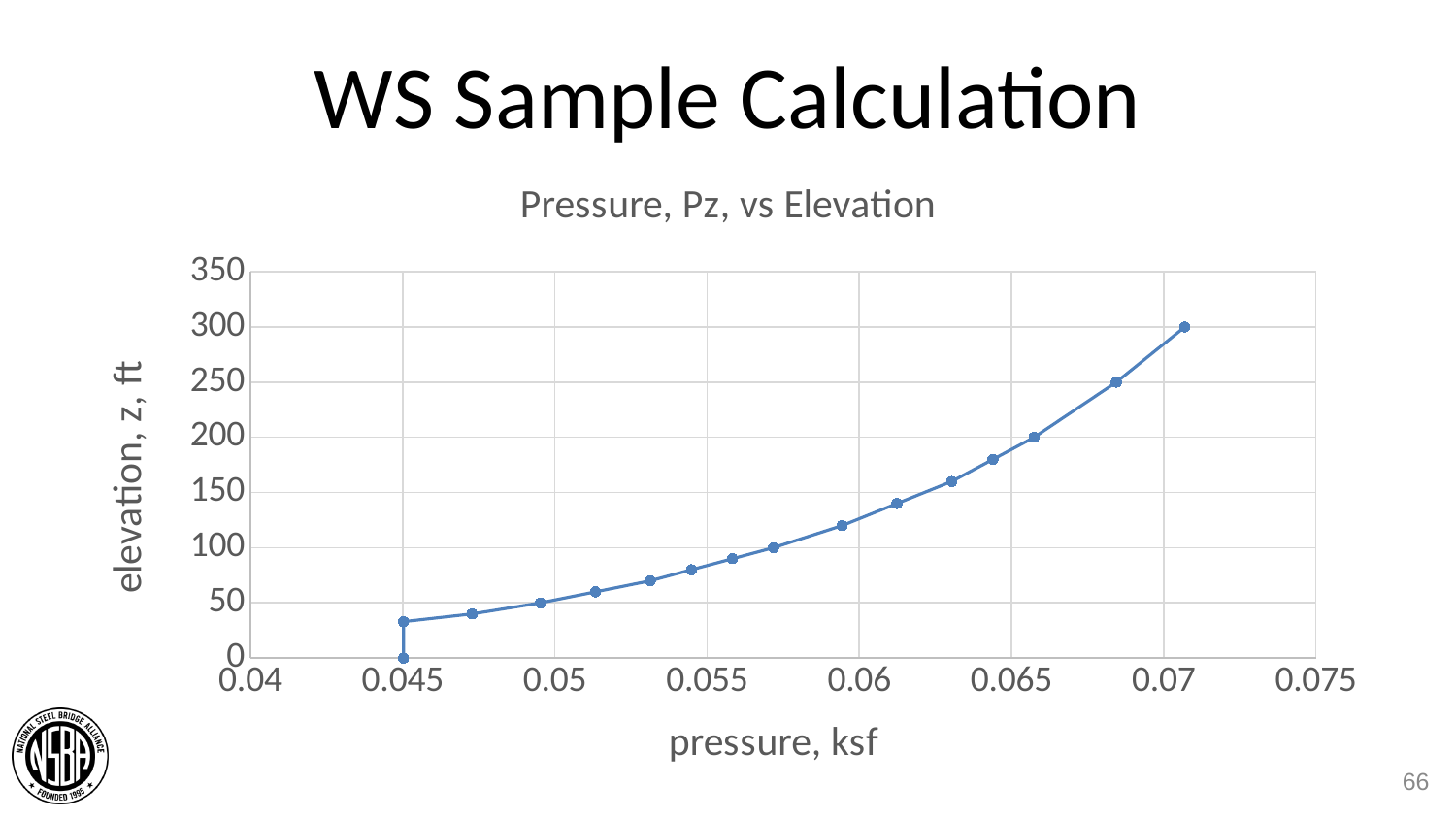
Is the pressure at an elevation of 300 ft greater or less than 0.07? greater What kind of chart is shown on the slide? line chart Is the pressure at an elevation of 50 ft greater or less than 0.05? less What is the highest elevation value plotted on the chart? 300 As pressure increases along the x axis, does elevation rise or fall? rise Is the pressure at an elevation of 200 ft greater or less than 0.065? greater What is the label of the horizontal axis of the chart? pressure, ksf How many data points are plotted on the chart? 16 What is the title of the chart? Pressure, Pz, vs Elevation What is the lowest pressure value plotted on the chart? 0.045